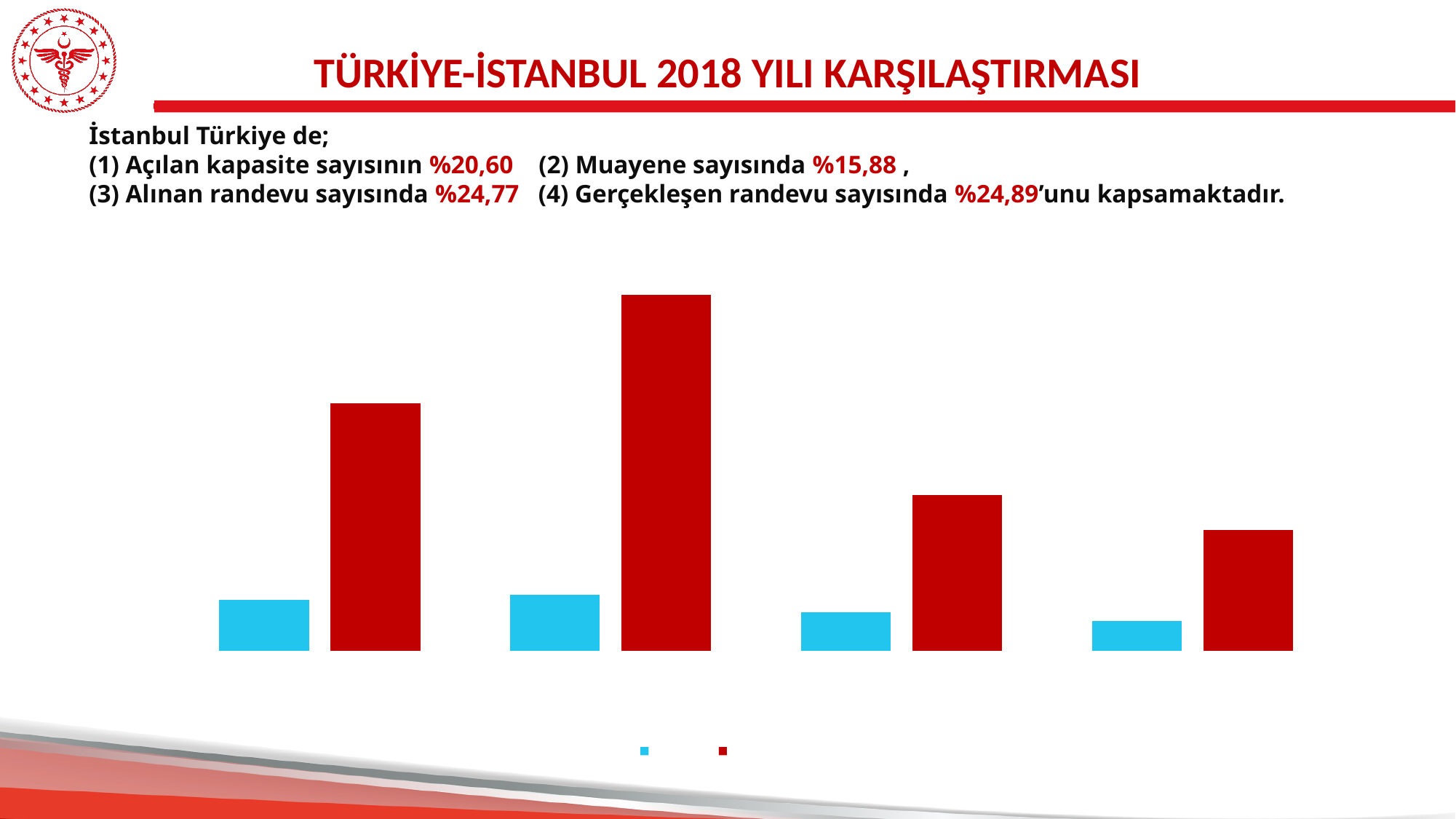
Which two colours are used for the bars in the chart? cyan and red What kind of chart is shown on the slide? bar chart Which group of bars, counted from the left, contains the tallest red bar? the second group How many groups of bars does the chart contain? 4 How many series does the chart's legend indicate? 2 Is the red bar in the first group from the left taller or shorter than the red bar in the second group? shorter Which group of bars, counted from the left, contains the shortest red bar? the fourth group In the fourth group of bars from the left, is the cyan bar taller or shorter than the red bar? shorter In the second group of bars from the left, which bar is taller, the cyan one or the red one? the red one Which group of bars, counted from the left, contains the shortest cyan bar? the fourth group